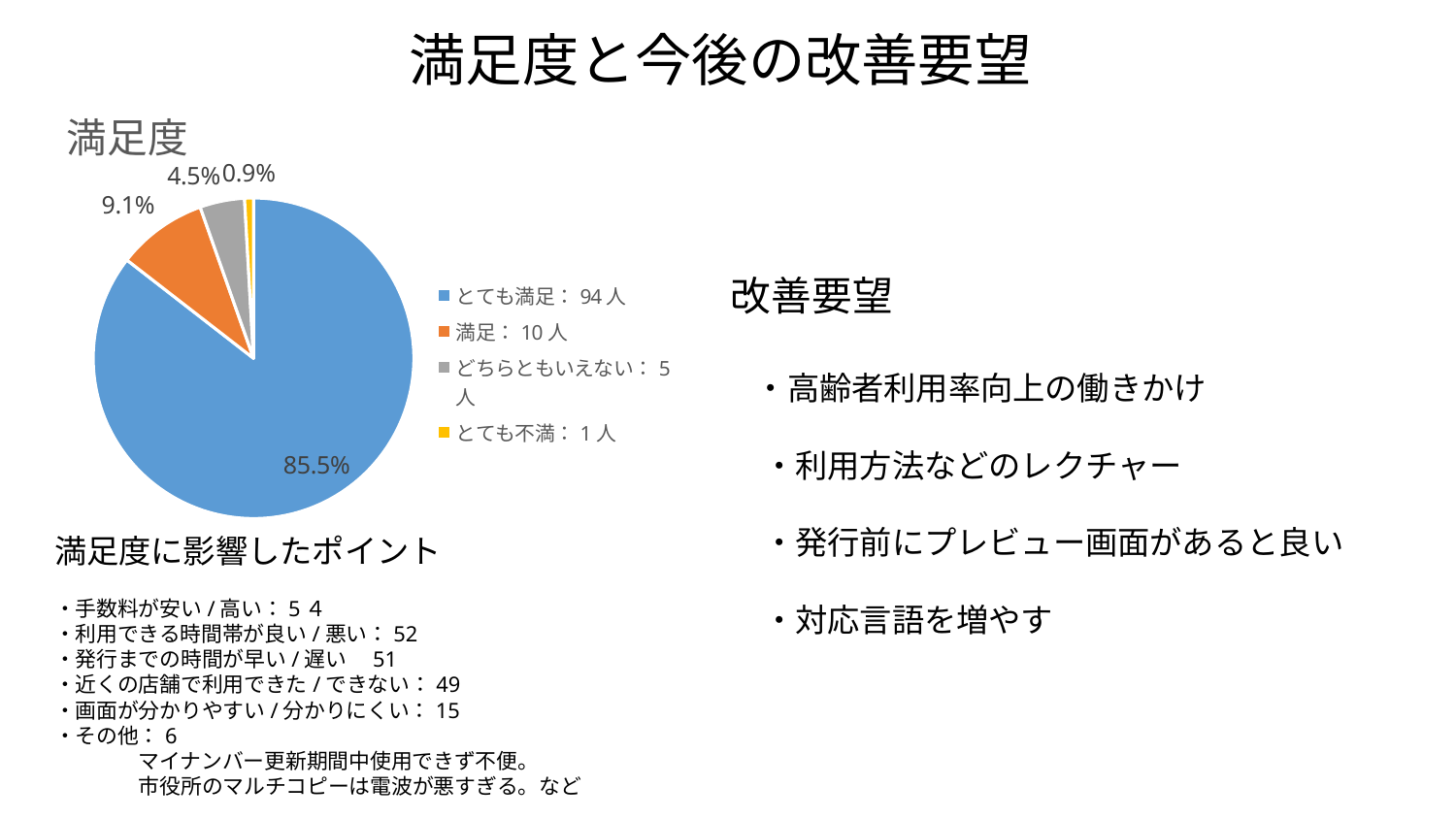
How many slices does the pie chart have? 4 What is the title of the chart? 満足度 What is the difference in percentage points between the とても満足 slice and the 満足 slice? 76.4% What percentage share does the 満足 slice have? 9.1% Which category has the smallest slice of the pie? とても不満 What percentage share does the どちらともいえない slice have? 4.5% What percentage share does the とても満足 slice have? 85.5% Which is larger, the 満足 slice or the どちらともいえない slice? 満足 Which category has the largest slice of the pie? とても満足 How many people answered とても満足 according to the legend? 94人 What type of chart is shown on the slide? pie chart